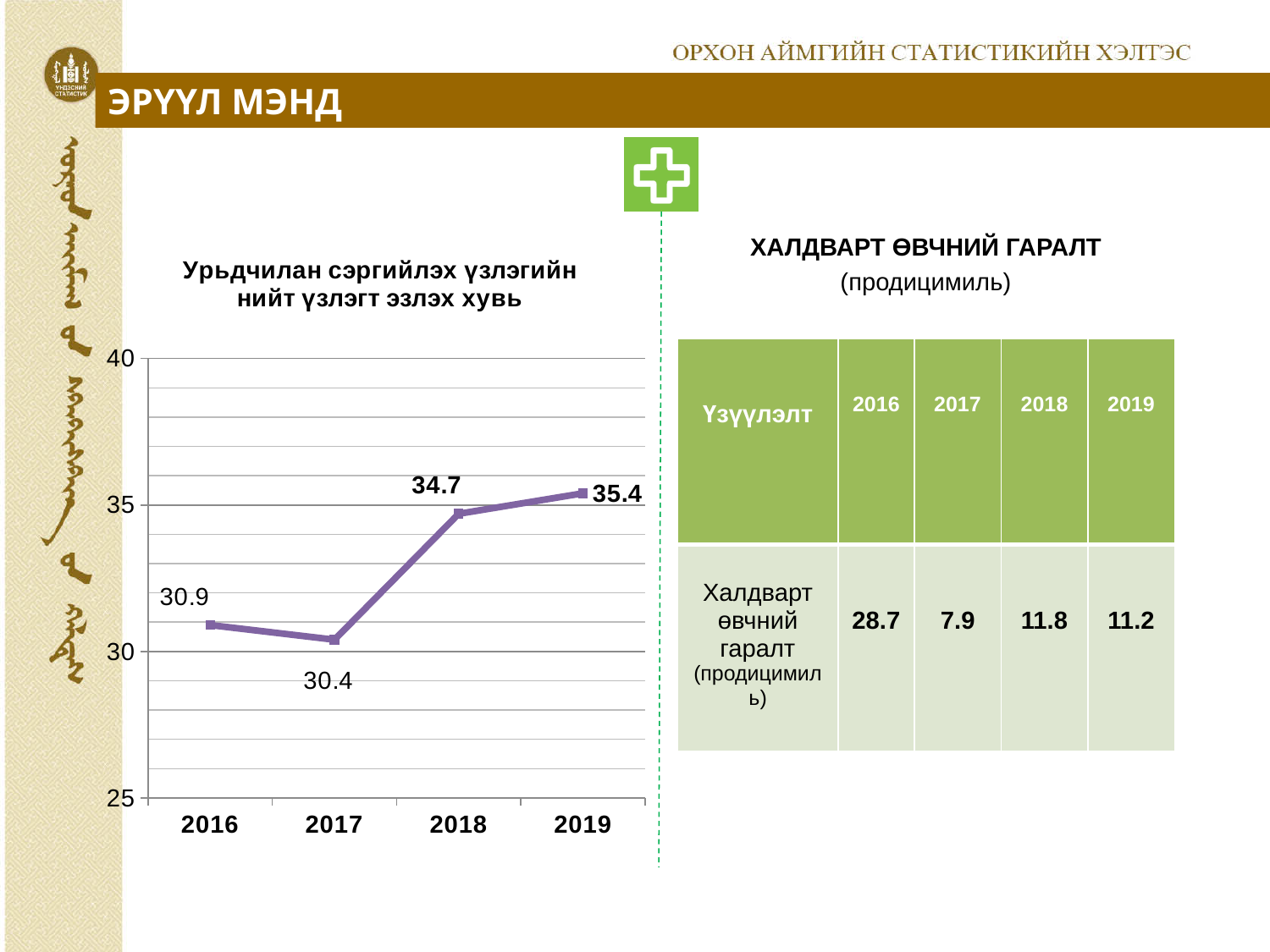
What type of chart is shown on the slide? line chart What is the value for 2016 in the line chart? 30.9 What is the value for 2019 in the line chart? 35.4 Which is larger in the line chart, the value for 2018 or the value for 2017? 2018 What is the value for 2018 in the line chart? 34.7 What is the title of the line chart? Урьдчилан сэргийлэх үзлэгийн нийт үзлэгт эзлэх хувь What is the value for 2017 in the line chart? 30.4 Is the value for 2018 in the line chart greater or less than 35? less What is the difference between the 2019 and 2016 values in the line chart? 4.5 How many years are plotted on the x axis of the line chart? 4 Which year has the lowest value in the line chart? 2017 Which year has the highest value in the line chart? 2019